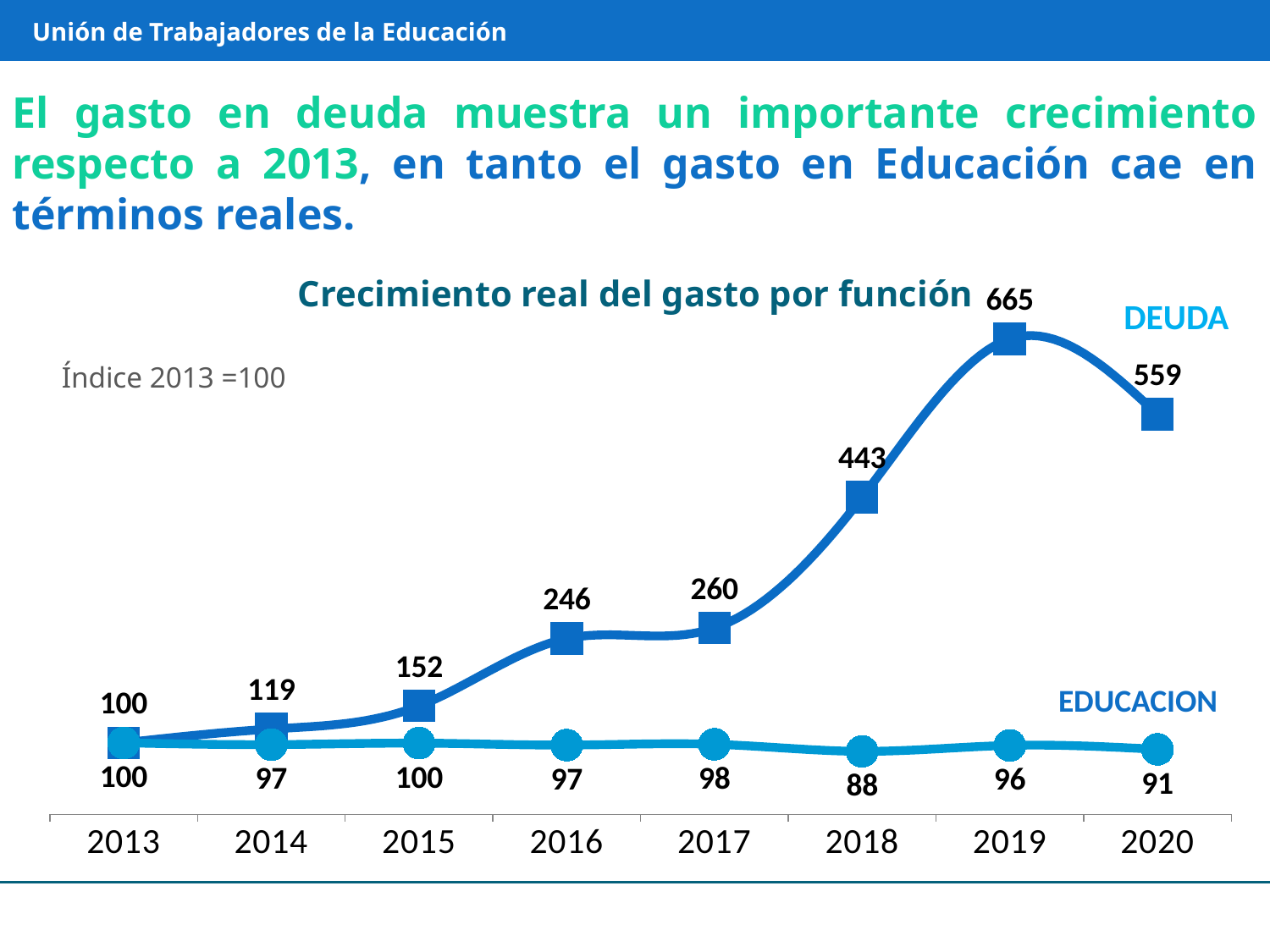
What kind of chart is shown? Line chart What is the value for DEUDA in 2016? 246 What is the value for EDUCACION in 2018? 88 Which is larger in 2017, the DEUDA value or the EDUCACION value? DEUDA Does the DEUDA series rise or fall from 2013 to 2019? Rise What is the title of the chart? Crecimiento real del gasto por función How many years are shown on the x axis? 8 In which year is the EDUCACION value lowest? 2018 What is the value for DEUDA in 2019? 665 How many series are plotted on the chart? 2 In which year does DEUDA reach its highest value? 2019 What is the difference between the DEUDA values for 2019 and 2020? 106